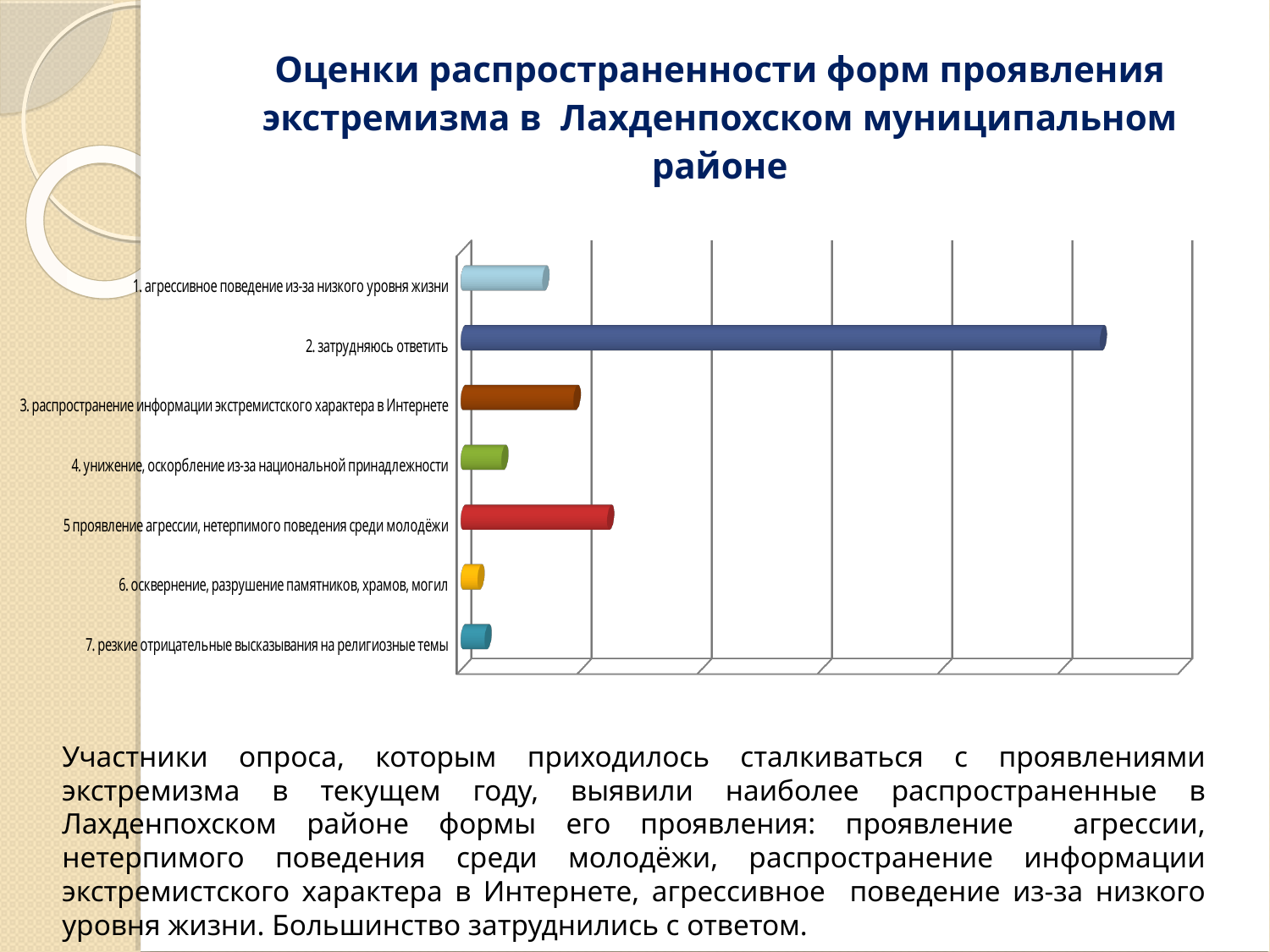
What is the title of the slide containing the chart? Оценки распространенности форм проявления экстремизма в Лахденпохском муниципальном районе Which bar is longer: '3. распространение информации экстремистского характера в Интернете' or '5 проявление агрессии, нетерпимого поведения среди молодёжи'? 5 проявление агрессии, нетерпимого поведения среди молодёжи Which bar is longer: '3. распространение информации экстремистского характера в Интернете' or '1. агрессивное поведение из-за низкого уровня жизни'? 3. распространение информации экстремистского характера в Интернете Which bar is longer: '2. затрудняюсь ответить' or '5 проявление агрессии, нетерпимого поведения среди молодёжи'? 2. затрудняюсь ответить What kind of chart is shown on the slide? bar chart What colour is the bar for '5 проявление агрессии, нетерпимого поведения среди молодёжи'? red Which category has the longest bar in the chart? 2. затрудняюсь ответить Which category has the second-longest bar in the chart? 5 проявление агрессии, нетерпимого поведения среди молодёжи How many categories are plotted in the chart? 7